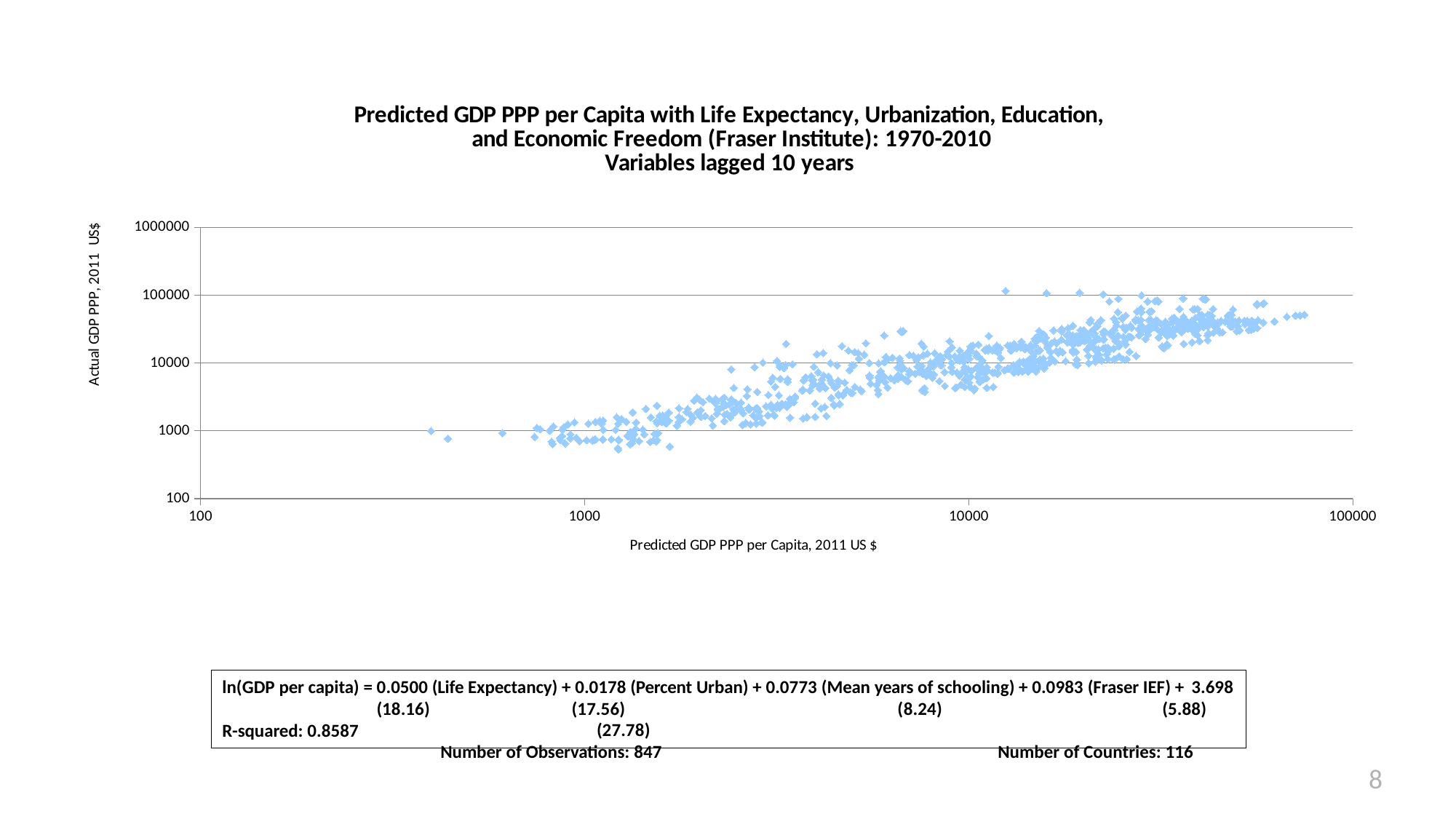
What is the title of the x axis of the chart? Predicted GDP PPP per Capita, 2011 US $ Do the plotted values of actual GDP PPP per capita rise or fall as predicted GDP PPP per capita increases along the x axis? rise What is the title of the y axis of the chart? Actual GDP PPP, 2011 US$ What kind of chart is shown on the slide? scatter plot